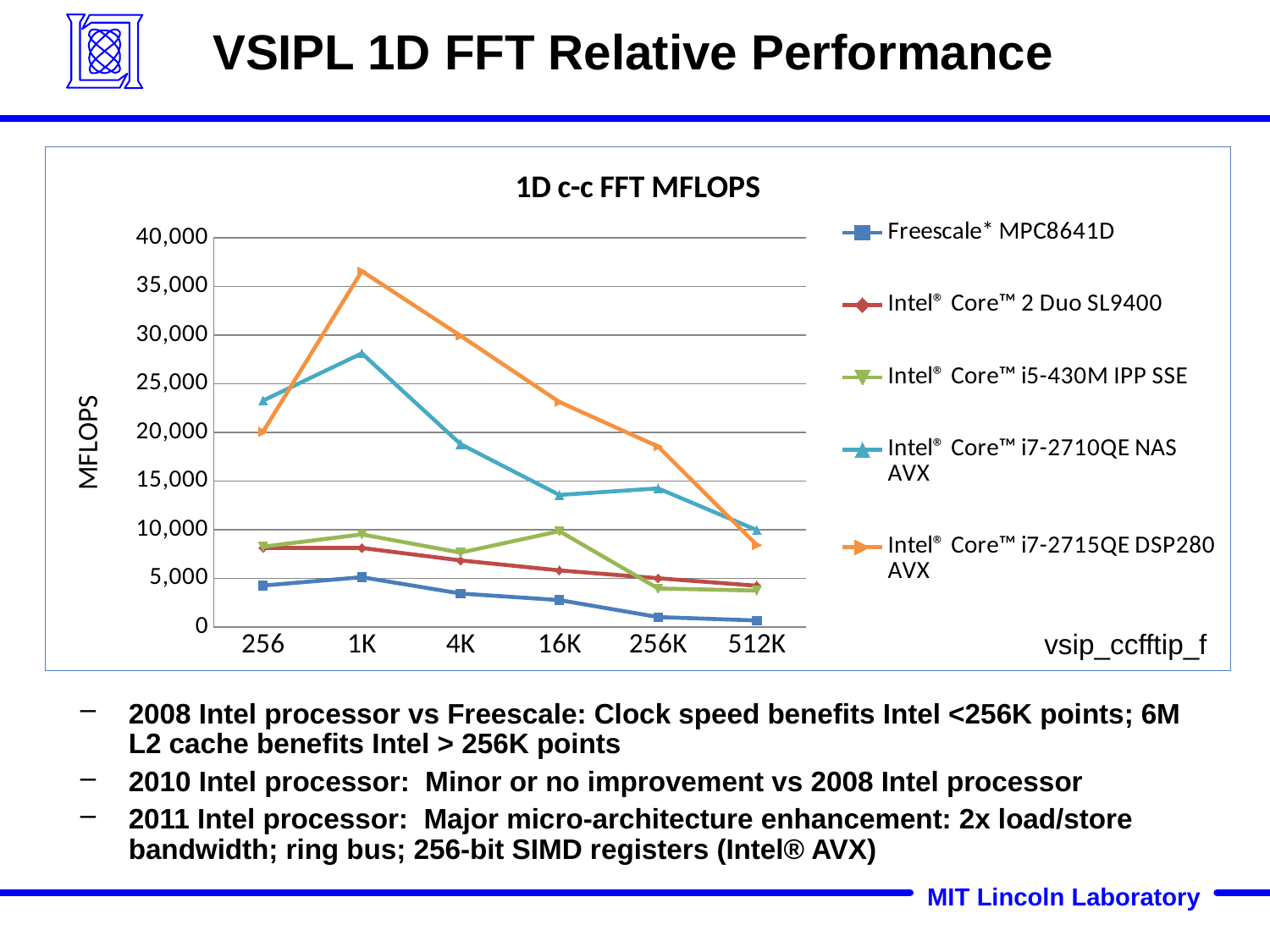
How many FFT size categories are shown on the x axis? 6 Is the value for Intel Core i7-2710QE NAS AVX at 256 greater or less than 20,000? greater Is the value for Freescale MPC8641D at 512K greater or less than 5,000? less Does the Intel Core i7-2715QE DSP280 AVX series rise or fall from 1K to 512K? fall What kind of chart is shown on the slide? line chart At which FFT size does the Intel Core i7-2715QE DSP280 AVX series reach its peak? 1K Is the value for Intel Core i7-2715QE DSP280 AVX at 1K greater or less than 35,000? greater Which series has the highest value at 1K? Intel Core i7-2715QE DSP280 AVX At 256 points, which series is higher: Intel Core i7-2710QE NAS AVX or Intel Core i7-2715QE DSP280 AVX? Intel Core i7-2710QE NAS AVX Which series has the lowest value at 512K? Freescale MPC8641D How many series does the legend list? 5 What is the title of the chart? 1D c-c FFT MFLOPS